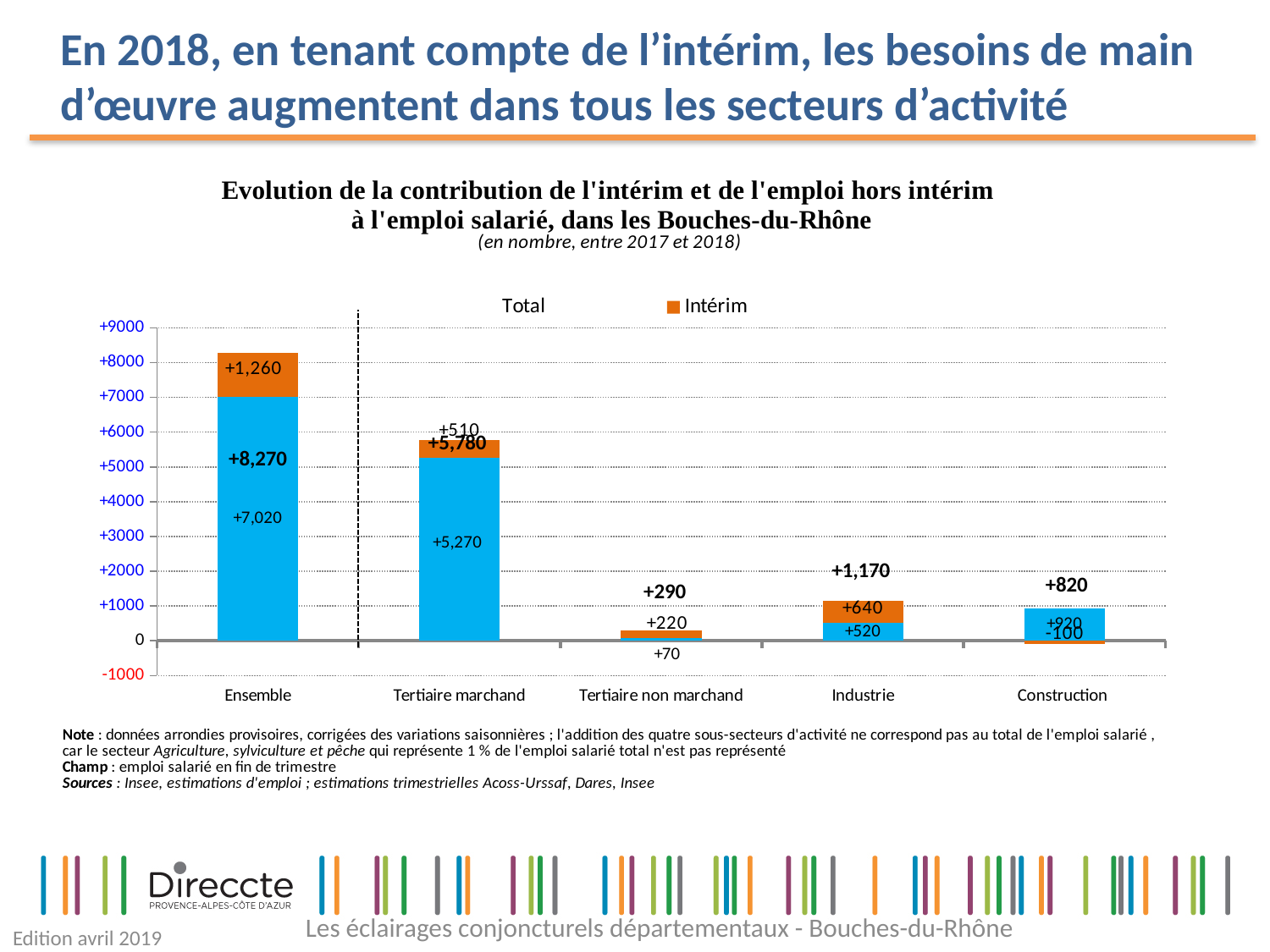
What is the Intérim value for Construction? -100 What is the total value labelled for Construction? +820 What is the difference between the Intérim value for Ensemble and the Intérim value for Tertiaire marchand? 750 Excluding Ensemble, which sector has the highest total value? Tertiaire marchand Which two entries does the legend list? Total and Intérim Which has the larger Intérim value, Industrie or Construction? Industrie Which category has the lowest total value? Tertiaire non marchand What is the total value labelled for Tertiaire marchand? +5,780 What kind of chart is shown on the slide? Bar chart How many categories are shown along the x axis of the chart? 5 What is the Intérim value for Industrie? +640 What is the Intérim value for Ensemble? +1,260